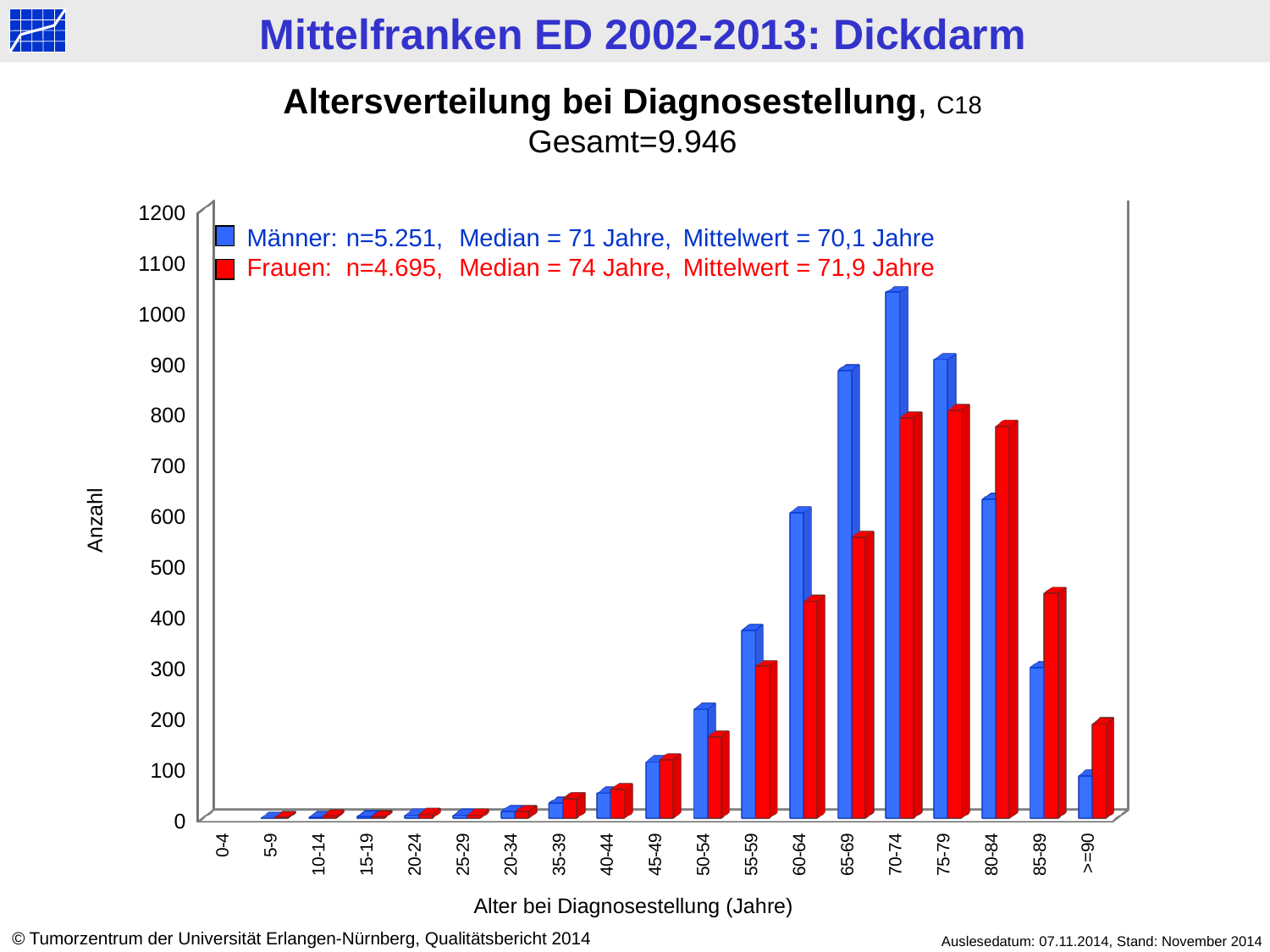
Is the Frauen value for the 65-69 age group greater or less than 500? greater Do the Männer values rise or fall from the 40-44 age group to the 70-74 age group? rise How many series does the legend list? 2 According to the legend, what is the n for Frauen? n=4.695 For which age group is the Männer value highest? 70-74 Is the Männer value for the 85-89 age group greater or less than 200? greater How many age-group categories are shown on the x axis? 19 In the 65-69 age group, which series has the larger value, Männer or Frauen? Männer In the 85-89 age group, which series has the larger value, Männer or Frauen? Frauen Is the Männer value for the 70-74 age group greater or less than 1000? greater What kind of chart is shown on the slide? bar chart